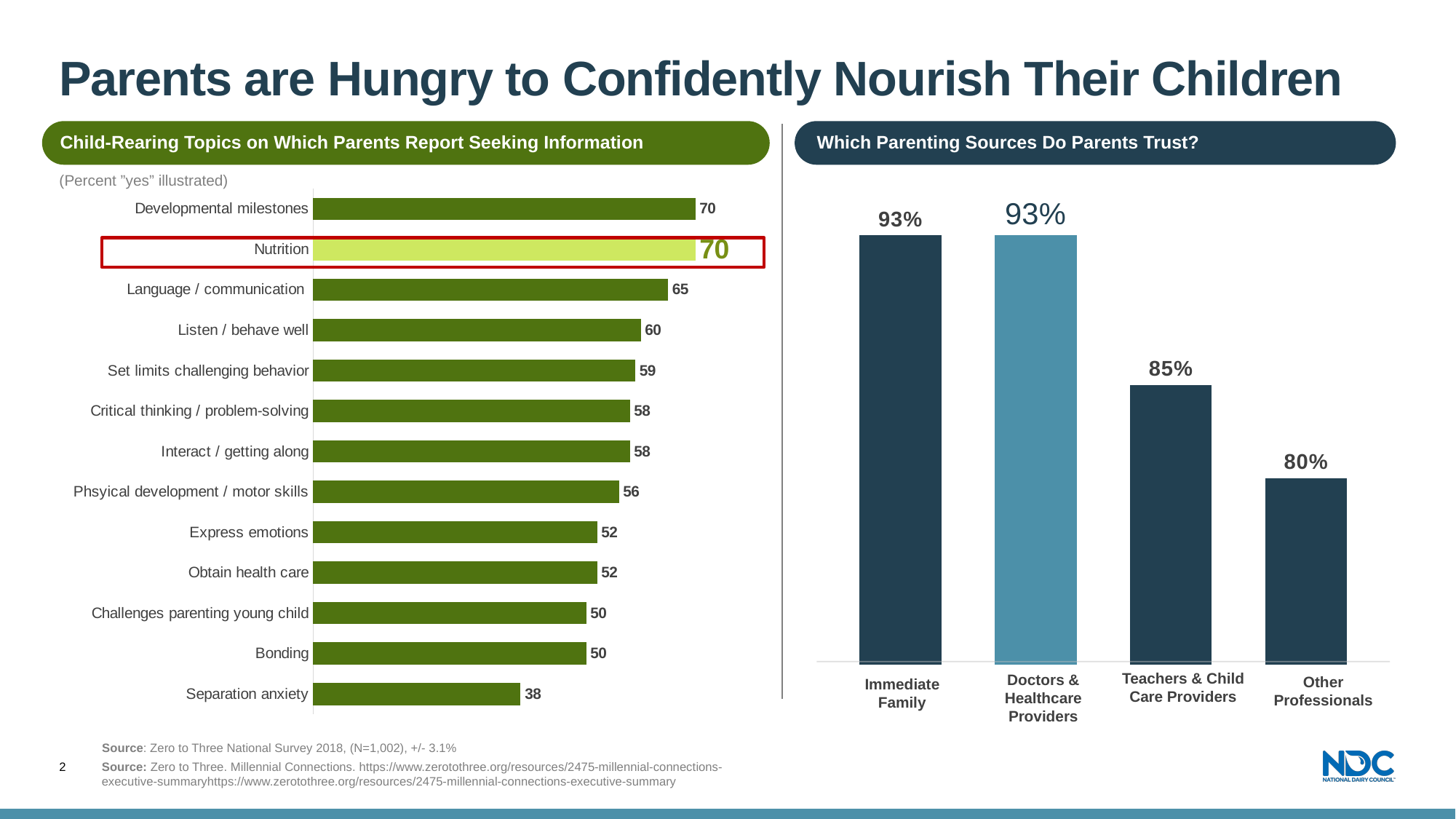
What kind of chart is the 'Child-Rearing Topics on Which Parents Report Seeking Information' chart? Bar chart How many topics are shown in the 'Child-Rearing Topics on Which Parents Report Seeking Information' chart? 13 In the 'Child-Rearing Topics on Which Parents Report Seeking Information' chart, what is the value for Separation anxiety? 38 In the 'Child-Rearing Topics on Which Parents Report Seeking Information' chart, what is the difference between Language / communication and Listen / behave well? 5 How many sources are shown in the 'Which Parenting Sources Do Parents Trust?' chart? 4 In the 'Child-Rearing Topics on Which Parents Report Seeking Information' chart, what is the value for Nutrition? 70 In the 'Which Parenting Sources Do Parents Trust?' chart, what is the value for Teachers & Child Care Providers? 85% In the 'Child-Rearing Topics on Which Parents Report Seeking Information' chart, which topic has the lowest value? Separation anxiety In the 'Which Parenting Sources Do Parents Trust?' chart, what is the difference between Immediate Family and Other Professionals? 13% In the 'Which Parenting Sources Do Parents Trust?' chart, which source has the lowest value? Other Professionals In the 'Which Parenting Sources Do Parents Trust?' chart, which bar is coloured differently (lighter blue) from the others? Doctors & Healthcare Providers In the 'Child-Rearing Topics on Which Parents Report Seeking Information' chart, which is larger: Express emotions or Bonding? Express emotions